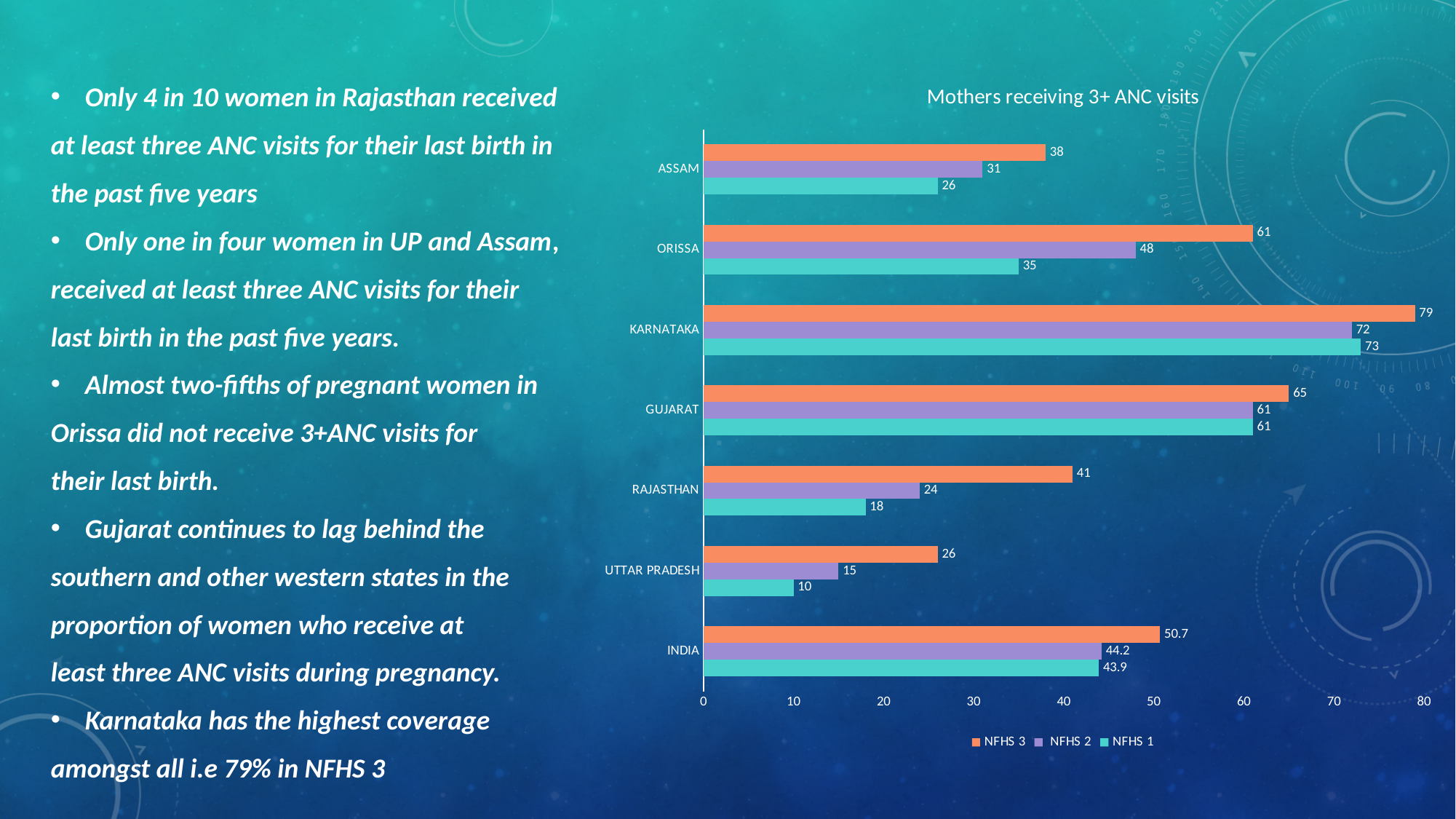
How many categories are shown on the chart? 7 Which category has the highest NFHS 3 value? Karnataka What is the NFHS 1 value for Uttar Pradesh? 10 Which category has the lowest NFHS 1 value? Uttar Pradesh Which series is shown in orange? NFHS 3 What is the NFHS 3 value for Karnataka? 79 Which is larger, the NFHS 2 value for Orissa or the NFHS 2 value for Assam? Orissa What kind of chart is shown on the slide? Bar chart What is the title of the chart? Mothers receiving 3+ ANC visits What is the difference between the NFHS 3 and NFHS 1 values for Rajasthan? 23 How many series does the legend list? 3 What is the NFHS 2 value for India? 44.2